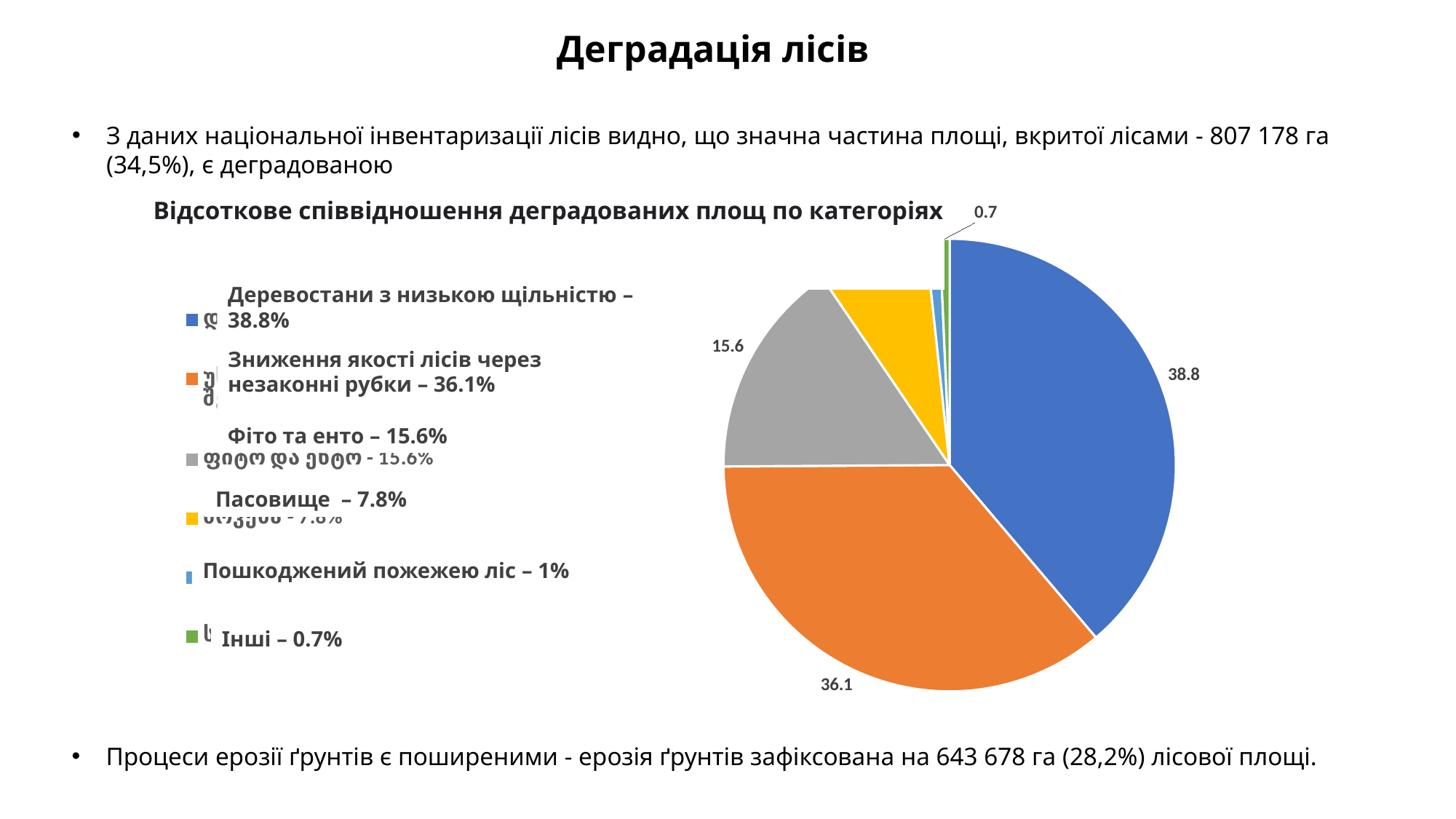
What is the value for Інші? 0.7% What is the value for Деревостани з низькою щільністю? 38.8% What is the title of the chart? Відсоткове співвідношення деградованих площ по категоріях What is the value for Пасовище? 7.8% What is the value for Фіто та енто? 15.6% Which is larger, the share for Фіто та енто or the share for Пасовище? Фіто та енто Which category has the smallest share of the pie? Інші What is the difference between the shares of Деревостани з низькою щільністю and Зниження якості лісів через незаконні рубки? 2.7% Which category has the largest share of the pie? Деревостани з низькою щільністю What kind of chart is shown on the slide? pie chart How many categories does the pie chart legend list? 6 What is the value for Зниження якості лісів через незаконні рубки? 36.1%